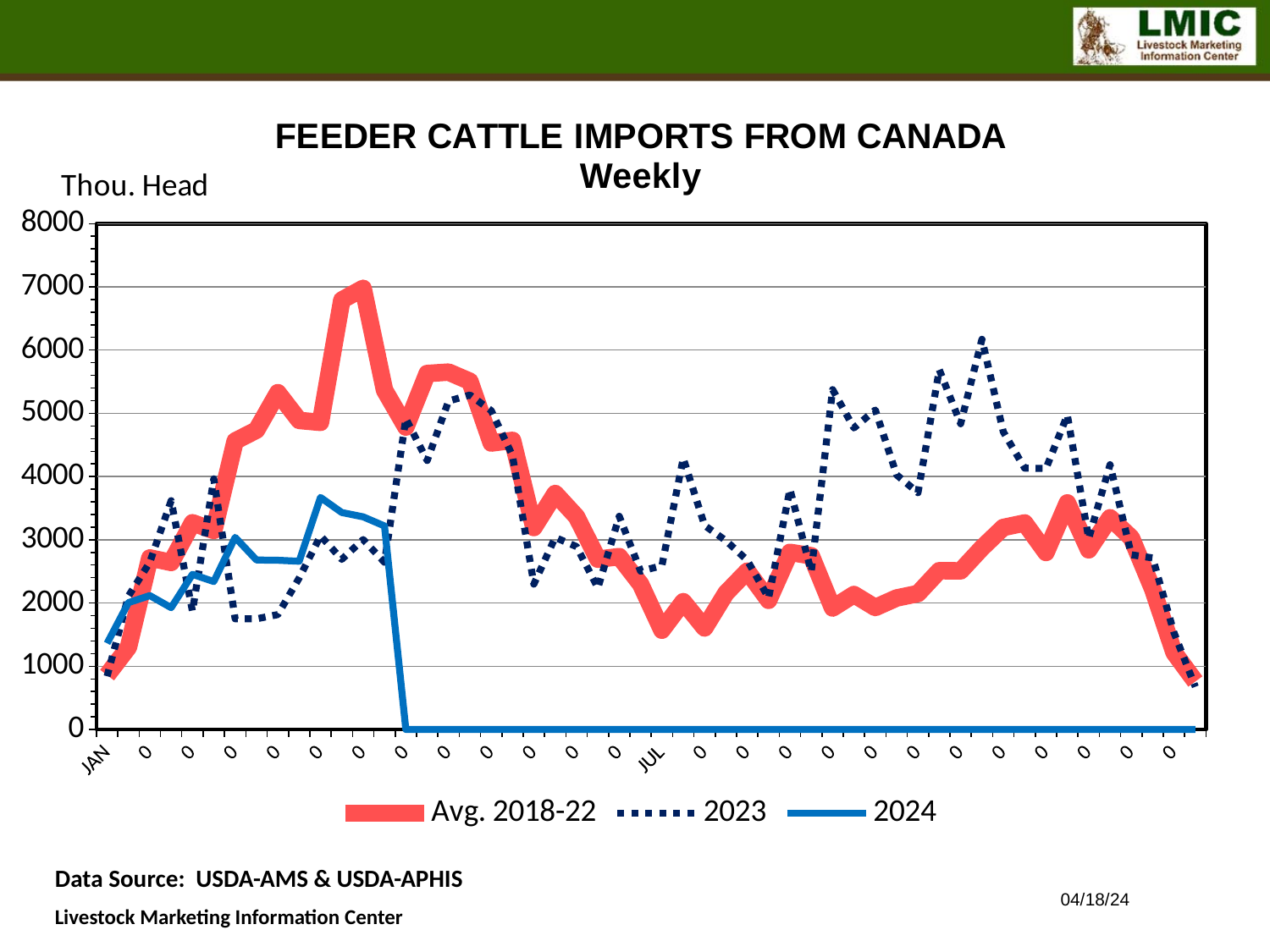
What are the three series named in the legend? Avg. 2018-22, 2023, 2024 Is the peak value of the Avg. 2018-22 line greater or less than 6000? greater What kind of chart is shown on the slide? line chart Is the value of the Avg. 2018-22 line at JAN greater or less than 2000? less Does the Avg. 2018-22 line end the year higher or lower than its value at JUL? lower Which series reaches the highest value on the chart? Avg. 2018-22 Is the peak value of the 2024 line greater or less than 4000? less Which is larger, the peak of the Avg. 2018-22 line or the peak of the 2024 line? Avg. 2018-22 How many series does the legend list? 3 What unit is shown on the y axis of the chart? Thou. Head